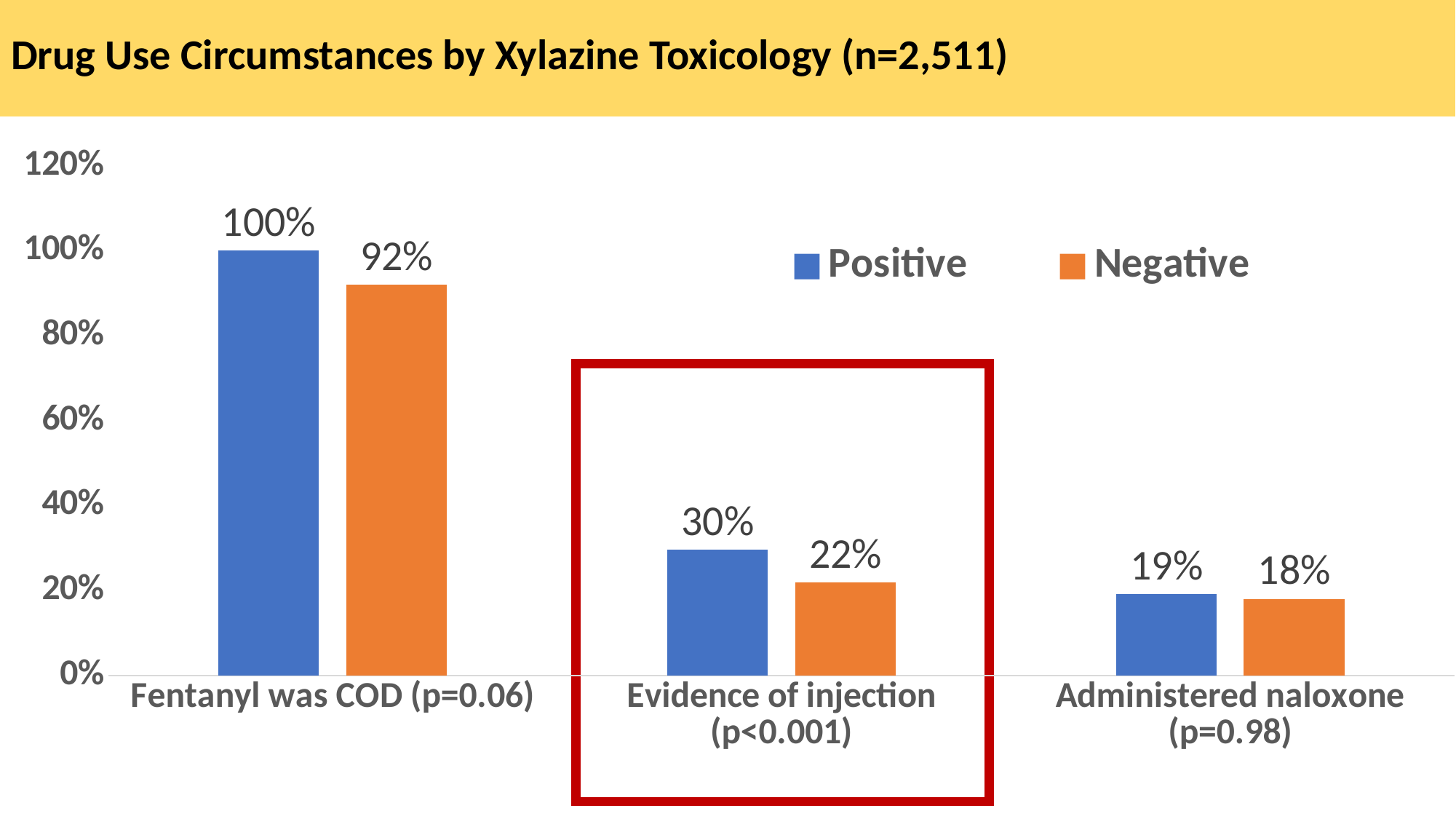
Which is larger for Evidence of injection (p<0.001), the Positive value or the Negative value? Positive What is the Positive value for Administered naloxone (p=0.98)? 19% How many series does the legend list? 2 What kind of chart is shown on the slide? Bar chart What is the difference between the Positive and Negative values for Evidence of injection (p<0.001)? 8% Which category has the highest Negative value? Fentanyl was COD (p=0.06) What is the difference between the Positive and Negative values for Fentanyl was COD (p=0.06)? 8% What is the title of the chart? Drug Use Circumstances by Xylazine Toxicology (n=2,511) How many categories are shown on the x axis? 3 Which category has the lowest Positive value? Administered naloxone (p=0.98) What is the Positive value for Fentanyl was COD (p=0.06)? 100% What is the Negative value for Evidence of injection (p<0.001)? 22%